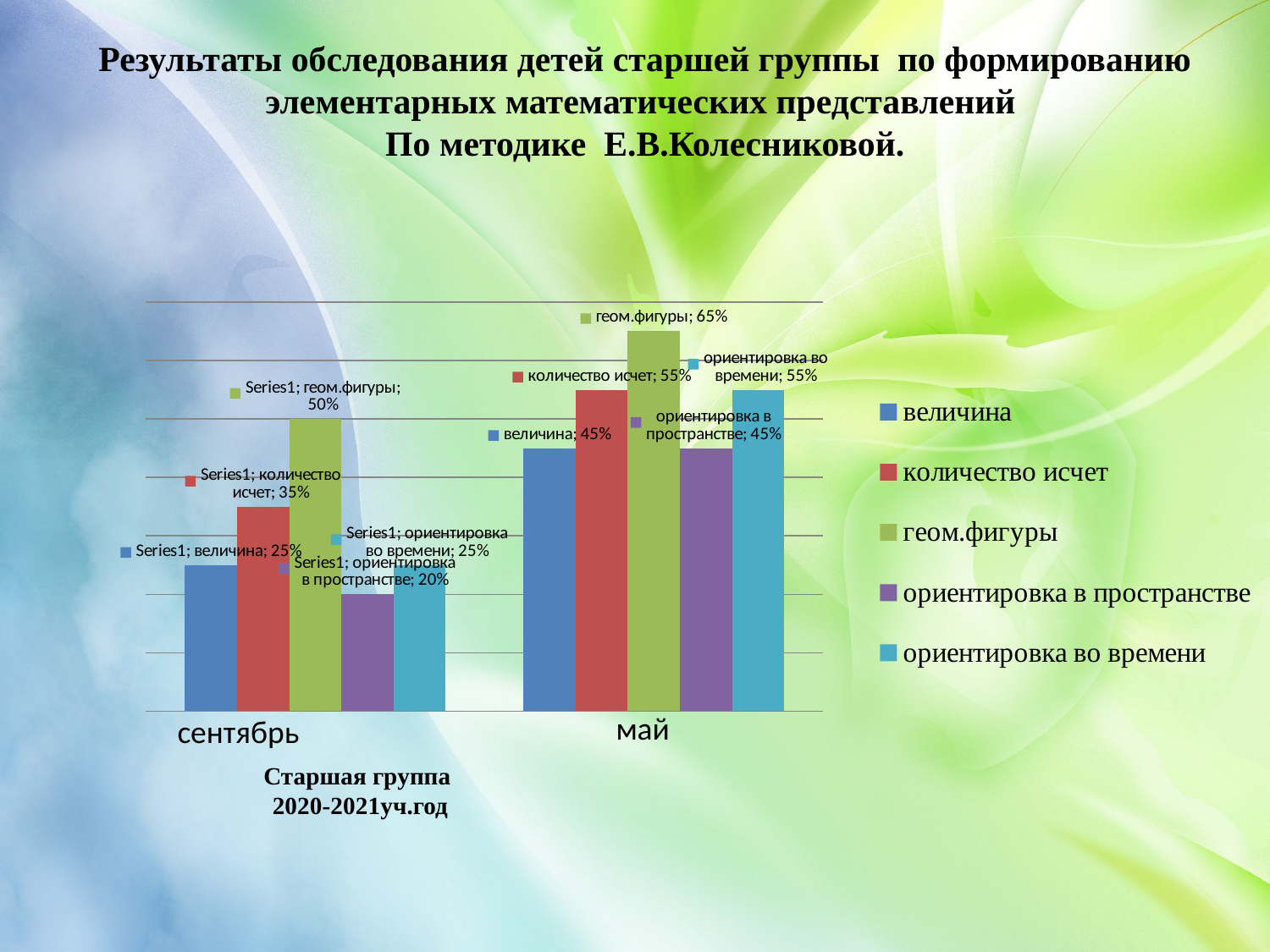
What is the difference between количество исчет and величина in сентябрь? 10% Which series has the highest value in май? геом.фигуры What is the value for количество исчет in май? 55% What is the value for величина in май? 45% What kind of chart is shown on the slide? bar chart Which is larger: ориентировка во времени in май or ориентировка в пространстве in май? ориентировка во времени in май How many series does the legend list? 5 Which series has the lowest value in сентябрь? ориентировка в пространстве What is the value for ориентировка в пространстве in сентябрь? 20% What is the difference between the геом.фигуры values for май and сентябрь? 15% What is the value for геом.фигуры in сентябрь? 50% Do the values for величина rise or fall from сентябрь to май? rise